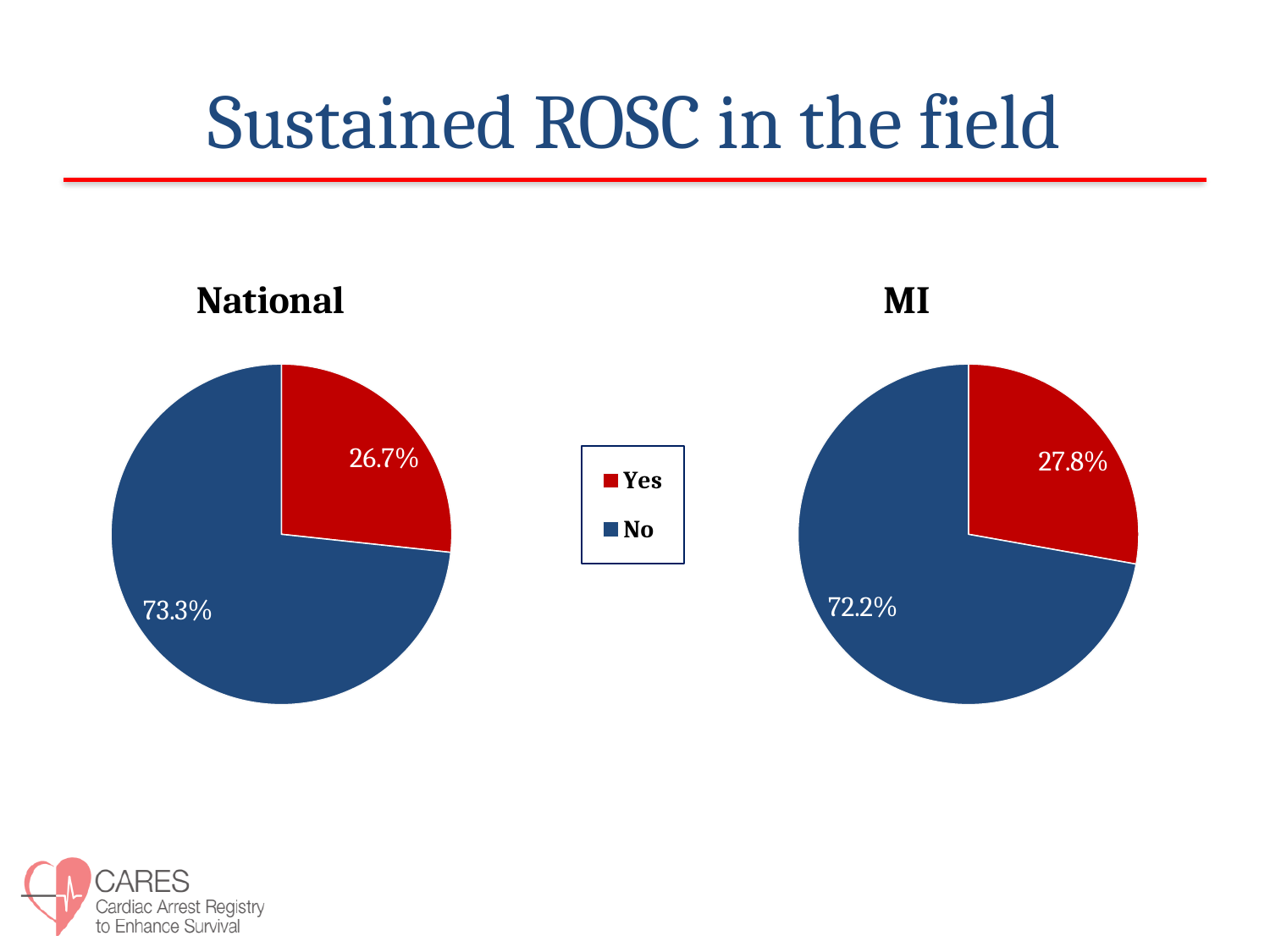
In the MI chart, what share of cases is labelled No? 72.2% In the National chart, what share of cases had sustained ROSC in the field (Yes)? 26.7% What colour represents Yes in the charts? Red In the National chart, what share of cases is labelled No? 73.3% In the National chart, which slice is the largest? No What type of chart is used on this slide? Pie chart In the MI chart, which slice is the smallest? Yes What is the difference between the Yes share in the MI chart and the Yes share in the National chart? 1.1% How many entries does the legend list? 2 How many slices does the National chart have? 2 In the MI chart, what share of cases is labelled Yes? 27.8% Is the Yes share larger in the National chart or the MI chart? MI